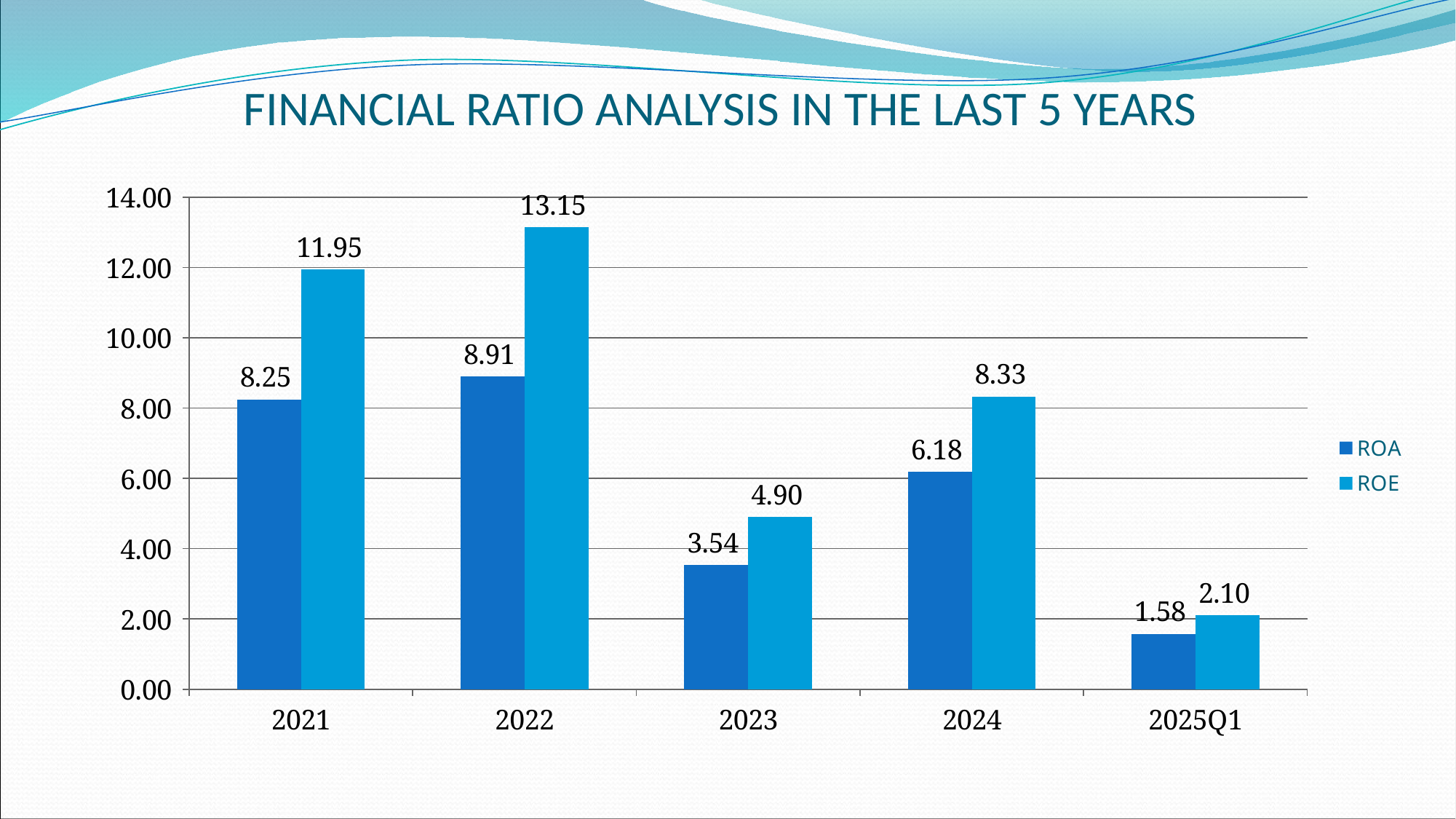
Which category has the lowest ROA value? 2025Q1 What is the ROE value for 2024? 8.33 Which year has the highest ROE value? 2022 What kind of chart is shown on the slide? Bar chart How many series does the legend list? 2 What is the difference between ROE and ROA in 2021? 3.70 Which is larger, the ROA value for 2023 or the ROA value for 2024? ROA for 2024 What is the ROA value for 2025Q1? 1.58 How many categories are shown on the x axis? 5 What is the ROA value for 2022? 8.91 Is the ROE value for 2023 greater or less than 4.00? greater What is the title of the chart? FINANCIAL RATIO ANALYSIS IN THE LAST 5 YEARS